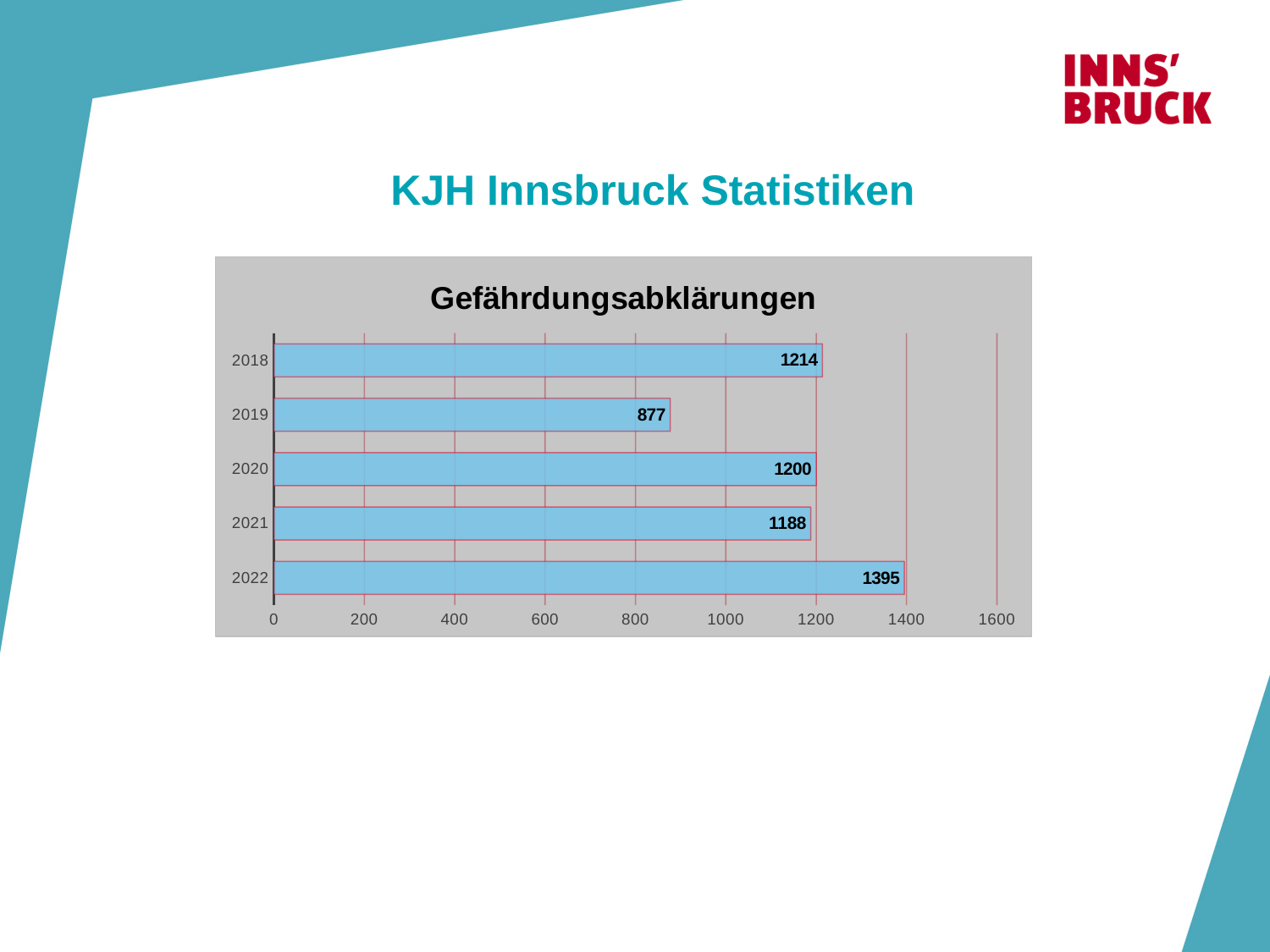
What is the difference between the values for 2020 and 2021 in the Gefährdungsabklärungen chart? 12 What kind of chart is the Gefährdungsabklärungen chart? bar chart Is the value for 2019 in the Gefährdungsabklärungen chart greater or less than 1000? less Which year has the lowest value in the Gefährdungsabklärungen chart? 2019 Which year has the highest value in the Gefährdungsabklärungen chart? 2022 What is the difference between the values for 2022 and 2019 in the Gefährdungsabklärungen chart? 518 What is the title of the chart on the slide? Gefährdungsabklärungen How many years are shown in the Gefährdungsabklärungen chart? 5 Which is larger in the Gefährdungsabklärungen chart, the value for 2018 or the value for 2021? 2018 What is the value for 2019 in the Gefährdungsabklärungen chart? 877 What is the value for 2022 in the Gefährdungsabklärungen chart? 1395 What is the value for 2018 in the Gefährdungsabklärungen chart? 1214